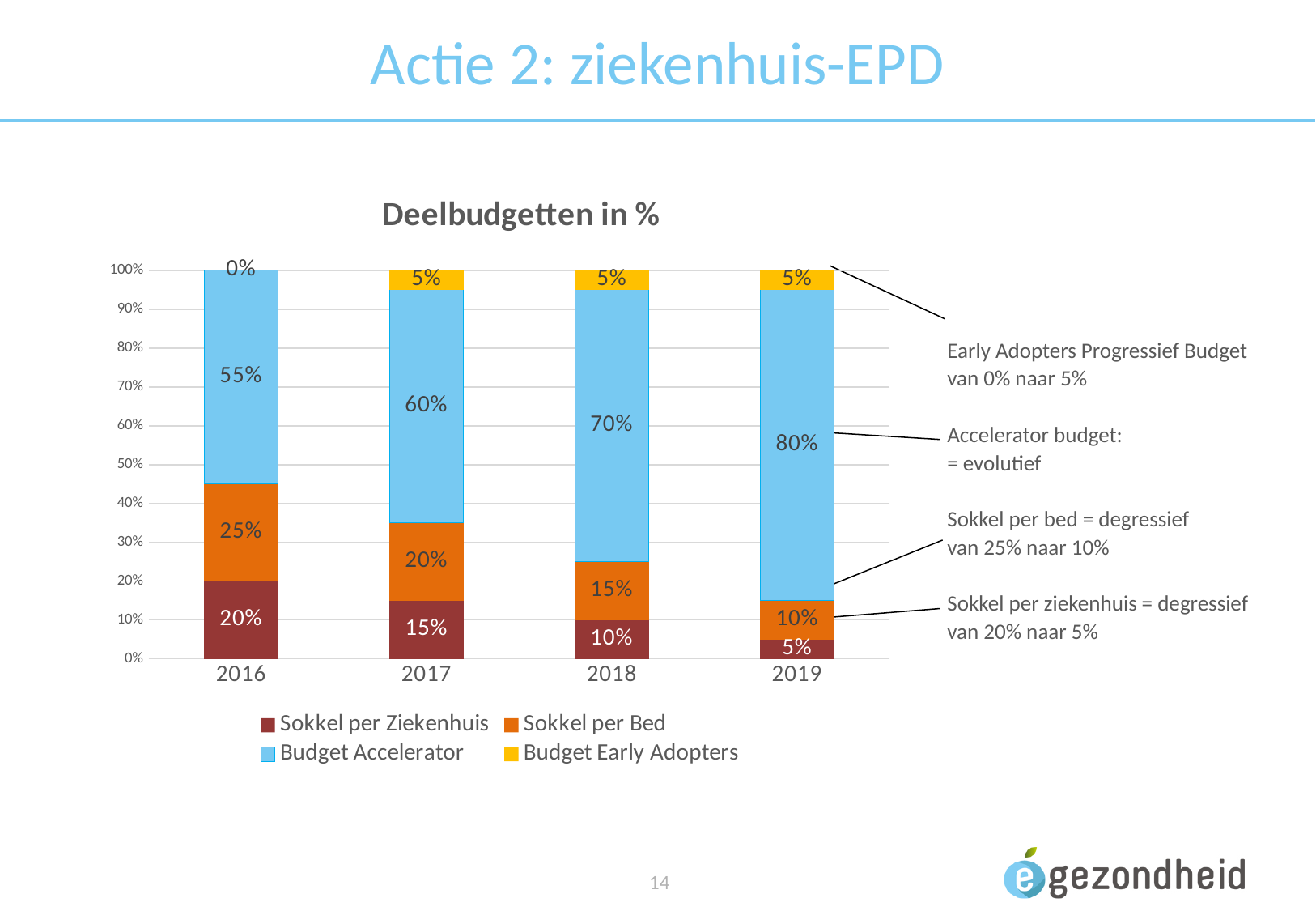
Which is larger: Sokkel per Bed in 2017 or Sokkel per Bed in 2019? Sokkel per Bed in 2017 How many years are shown on the x axis? 4 Does Sokkel per Bed rise or fall from 2016 to 2019? Fall What is the value for Budget Early Adopters in 2016? 0% In which year is Sokkel per Ziekenhuis lowest? 2019 In which year is Budget Accelerator highest? 2019 What is the value for Sokkel per Ziekenhuis in 2019? 5% What is the difference between Budget Accelerator in 2019 and in 2016? 25% What is the value for Budget Accelerator in 2018? 70% How many series does the legend list? 4 What is the value for Sokkel per Bed in 2016? 25% What kind of chart is shown? Stacked bar chart